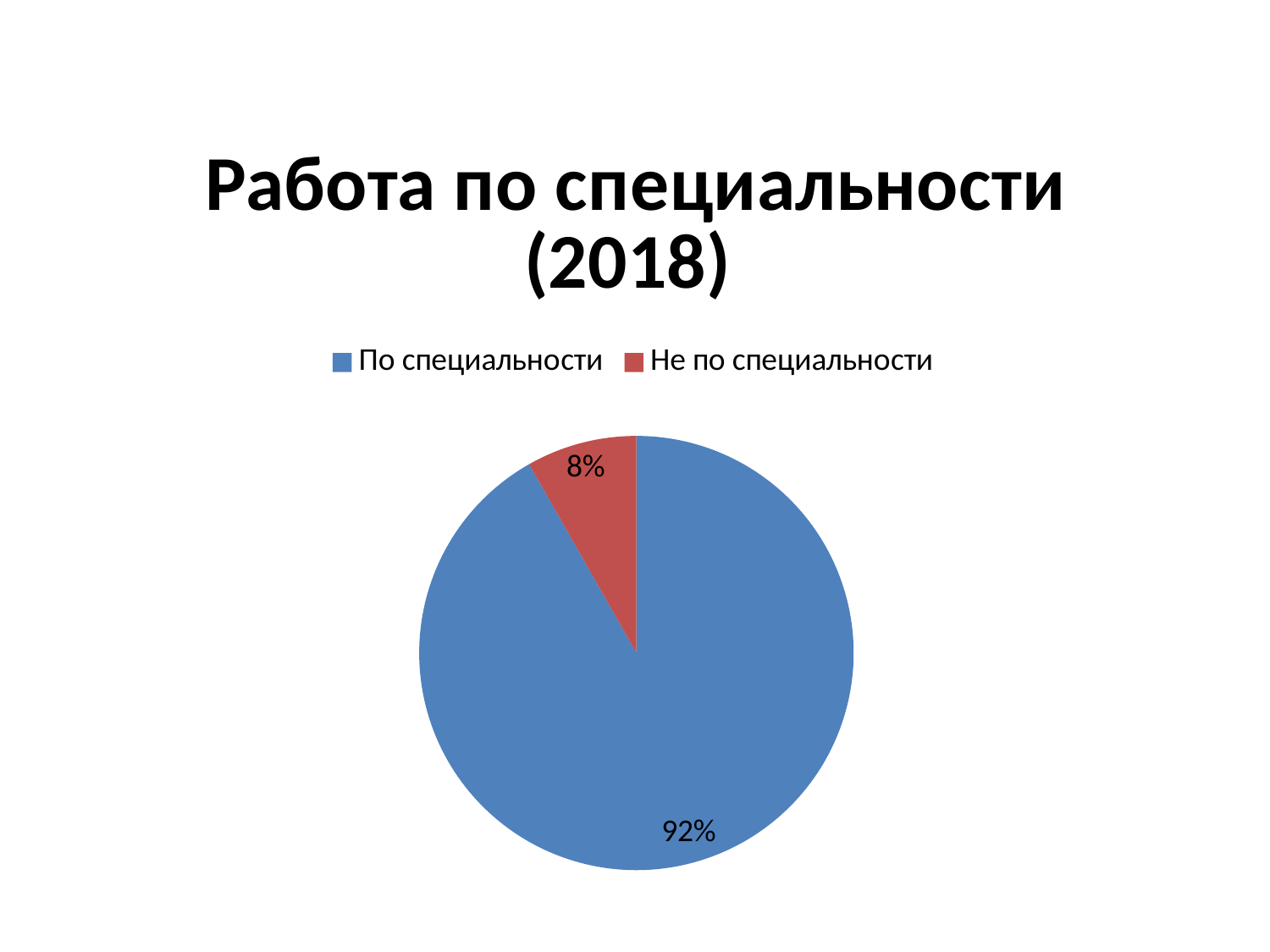
How many entries does the legend list? 2 What is the title of the chart? Работа по специальности (2018) Which slice is the smallest? Не по специальности What share of the pie is labelled "По специальности"? 92% What colour is the "Не по специальности" slice? red What kind of chart is shown on the slide? pie chart Which slice is the largest? По специальности Which is larger, the "По специальности" slice or the "Не по специальности" slice? По специальности How many slices does the pie chart have? 2 What share of the pie is labelled "Не по специальности"? 8% What is the difference in percentage points between the "По специальности" and "Не по специальности" slices? 84